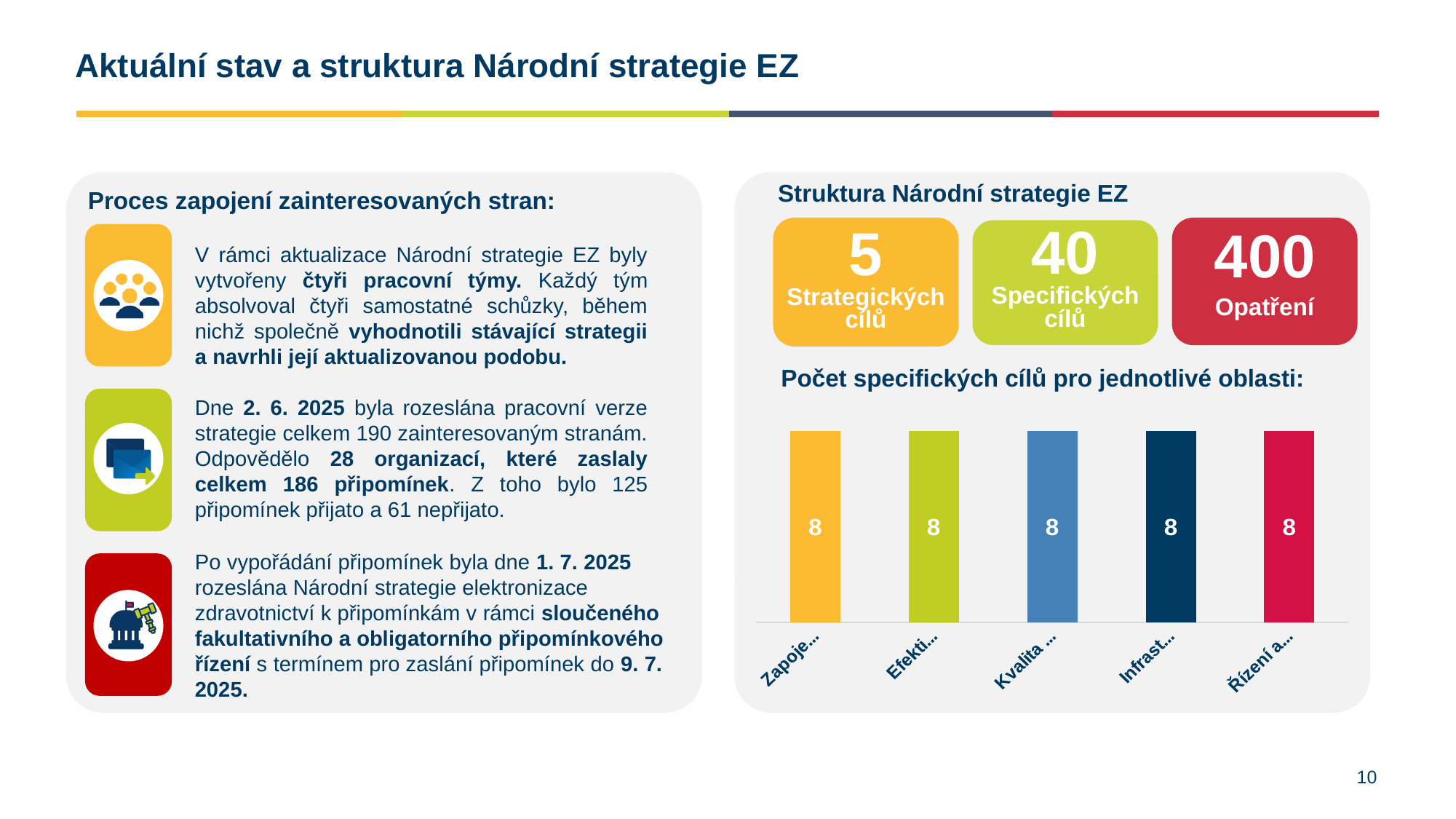
In the chart "Počet specifických cílů pro jednotlivé oblasti", what value is printed on the middle (light blue) bar? 8 In the chart "Počet specifických cílů pro jednotlivé oblasti", do the values rise, fall, or stay the same from left to right? stay the same In the chart "Počet specifických cílů pro jednotlivé oblasti", what is the sum of the values of all five bars? 40 In the chart "Počet specifických cílů pro jednotlivé oblasti", what is the difference between the value of the green bar and the value of the red bar? 0 What is the heading printed directly above the bar chart on the right side of the slide? Počet specifických cílů pro jednotlivé oblasti: In the chart "Počet specifických cílů pro jednotlivé oblasti", is the value of the first bar larger than, smaller than, or equal to the value of the last bar? equal In the chart "Počet specifických cílů pro jednotlivé oblasti", what value is printed on the leftmost (yellow) bar? 8 What kind of chart is shown under the heading "Počet specifických cílů pro jednotlivé oblasti"? bar chart What colour is the second bar from the left in the chart "Počet specifických cílů pro jednotlivé oblasti"? green How many bars does the chart "Počet specifických cílů pro jednotlivé oblasti" contain? 5 In the chart "Počet specifických cílů pro jednotlivé oblasti", what value is printed on the rightmost (red) bar? 8 In the chart "Počet specifických cílů pro jednotlivé oblasti", what value is printed on the dark blue bar? 8